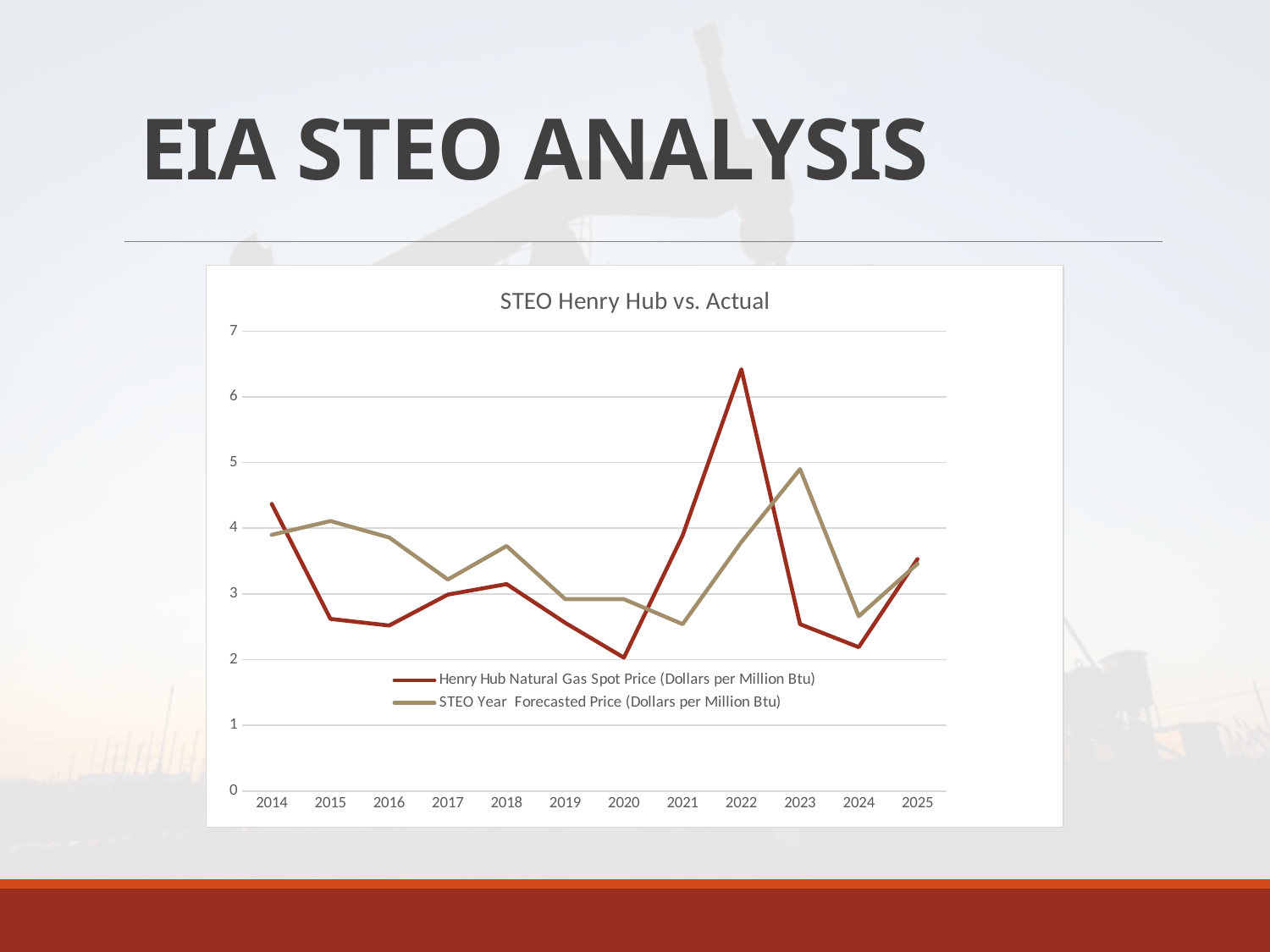
In which year does the Henry Hub Natural Gas Spot Price reach its highest value? 2022 How many years are shown on the x axis? 12 Is the Henry Hub Natural Gas Spot Price in 2020 greater or less than 3? less In 2022, which series has the higher value: Henry Hub Natural Gas Spot Price or STEO Year Forecasted Price? Henry Hub Natural Gas Spot Price In which year does the STEO Year Forecasted Price reach its highest value? 2023 Is the STEO Year Forecasted Price in 2021 greater or less than 3? less What kind of chart is shown on the slide? line chart How many series does the legend list? 2 Is the Henry Hub Natural Gas Spot Price in 2022 greater or less than 6? greater In which year is the Henry Hub Natural Gas Spot Price at its lowest? 2020 In 2023, which series has the higher value: Henry Hub Natural Gas Spot Price or STEO Year Forecasted Price? STEO Year Forecasted Price What is the title of the chart? STEO Henry Hub vs. Actual